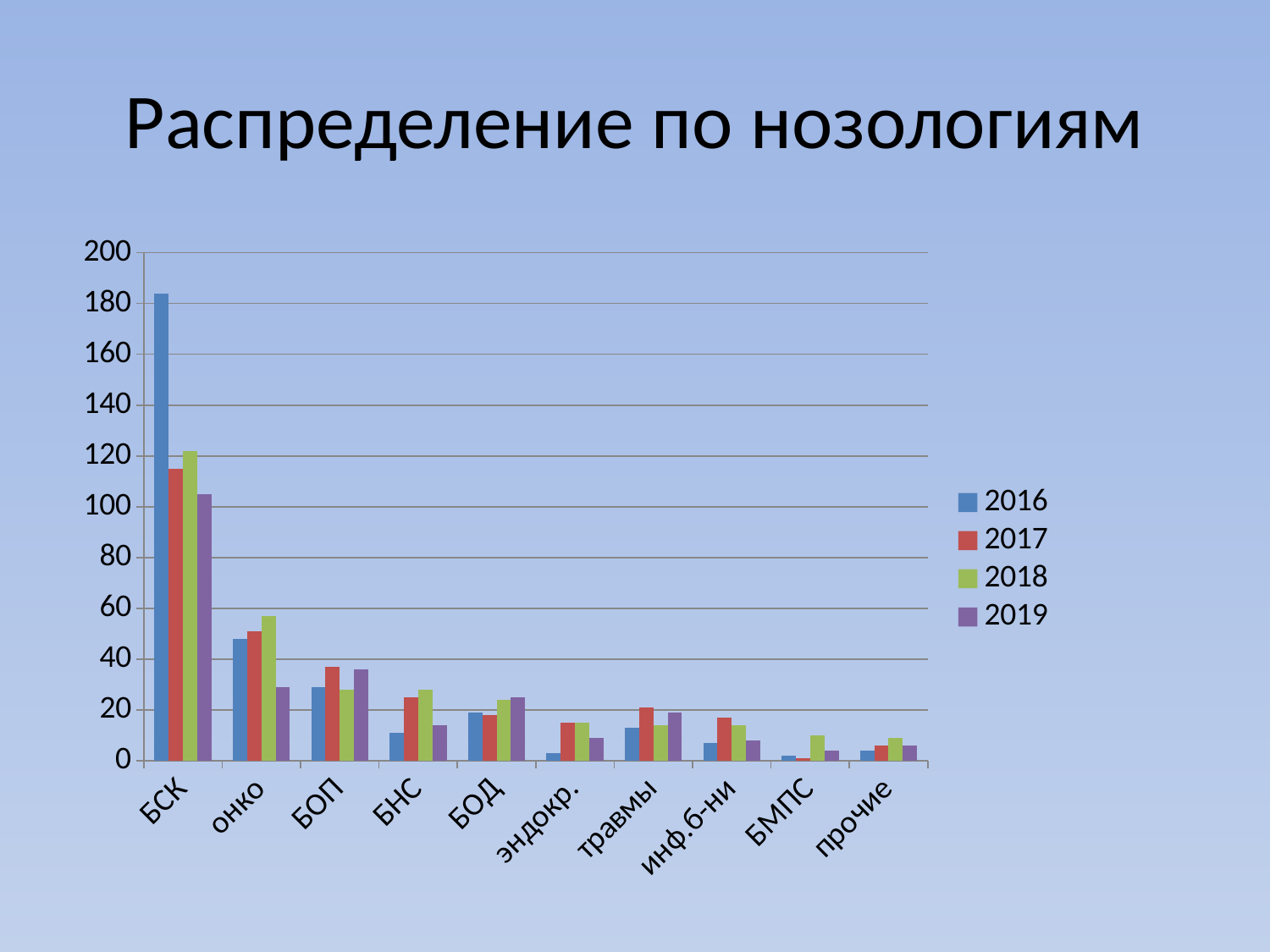
Is the value for БНС in 2016 greater or less than 20? less Which is larger: the value for онко in 2018 or the value for онко in 2019? 2018 How many series does the legend list? 4 How many categories are shown on the x axis? 10 Which category has the lowest values across all years? БМПС For БСК, which year has the highest value? 2016 Is the value for БСК in 2016 greater or less than 160? greater What is the title of the chart on the slide? Распределение по нозологиям For онко, which year has the highest value? 2018 What kind of chart is shown on the slide? bar chart Which category has the highest bar on the chart? БСК Is the value for онко in 2018 greater or less than 40? greater